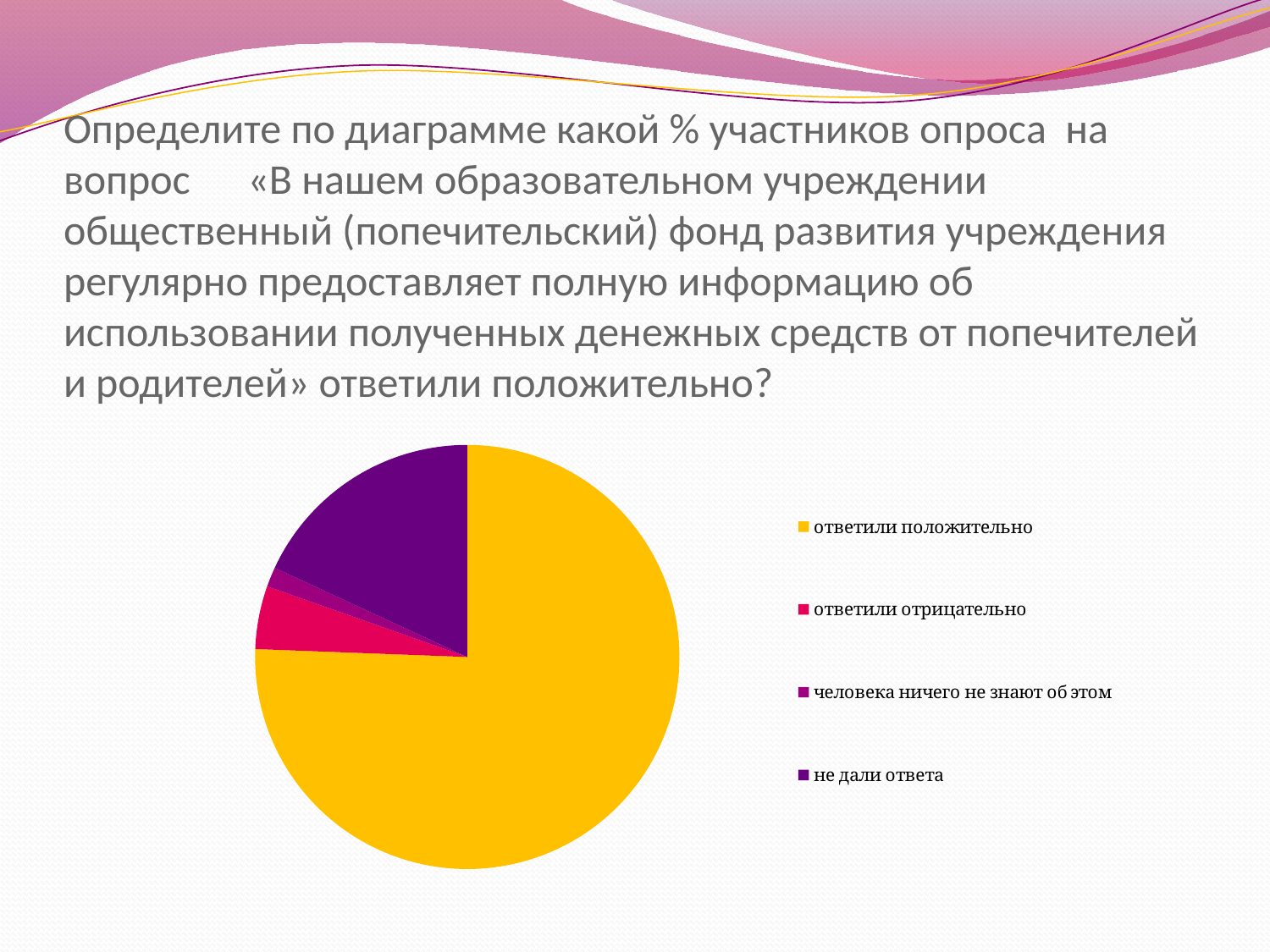
Which category has the largest slice of the pie chart? ответили положительно Does the slice for "ответили положительно" take up more or less than half of the pie? more Which slice is larger: "ответили положительно" or "не дали ответа"? ответили положительно What kind of chart is shown on the slide? pie chart What colour is the slice for "ответили положительно"? yellow How many entries does the legend of the pie chart list? 4 Which slice is larger: "ответили отрицательно" or "человека ничего не знают об этом"? ответили отрицательно How many categories (slices) does the pie chart have? 4 Which category is shown in dark purple in the pie chart? не дали ответа Which category has the smallest slice of the pie chart? человека ничего не знают об этом